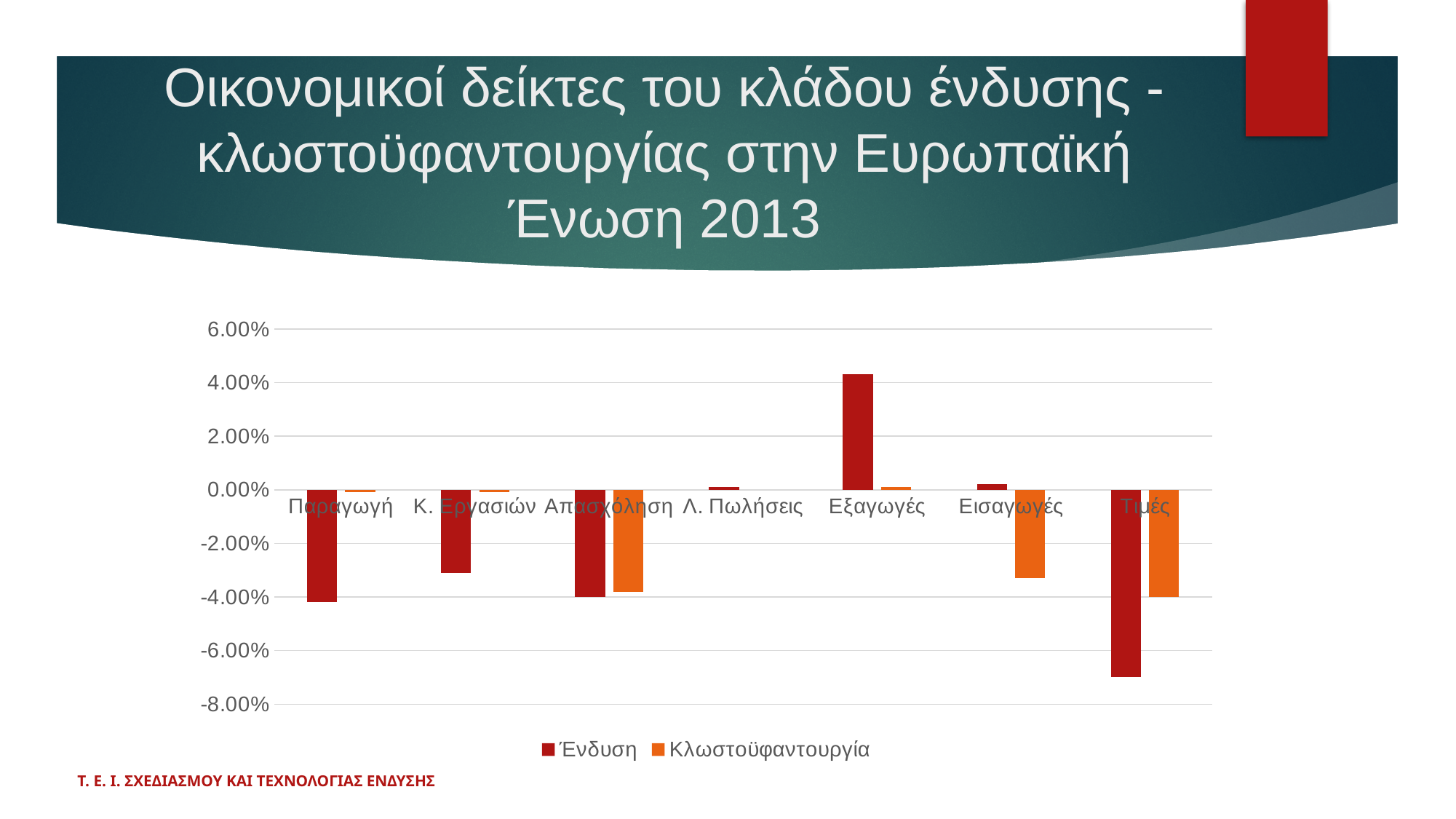
For Εισαγωγές, which series has the larger value, Ένδυση or Κλωστοϋφαντουργία? Ένδυση Which category has the highest value for the Ένδυση series? Εξαγωγές Which category has the lowest value for the Κλωστοϋφαντουργία series? Τιμές What kind of chart is shown on the slide? bar chart Is the Ένδυση value for Εξαγωγές greater or less than 4.00%? greater For Παραγωγή, which series has the larger value, Ένδυση or Κλωστοϋφαντουργία? Κλωστοϋφαντουργία How many series does the legend list? 2 Is the Κλωστοϋφαντουργία value for Εισαγωγές greater or less than -2.00%? less Is the Ένδυση value for Τιμές greater or less than -6.00%? less How many categories are shown on the x axis of the chart? 7 Which category has the lowest value for the Ένδυση series? Τιμές Which colour represents the Κλωστοϋφαντουργία series in the legend? orange